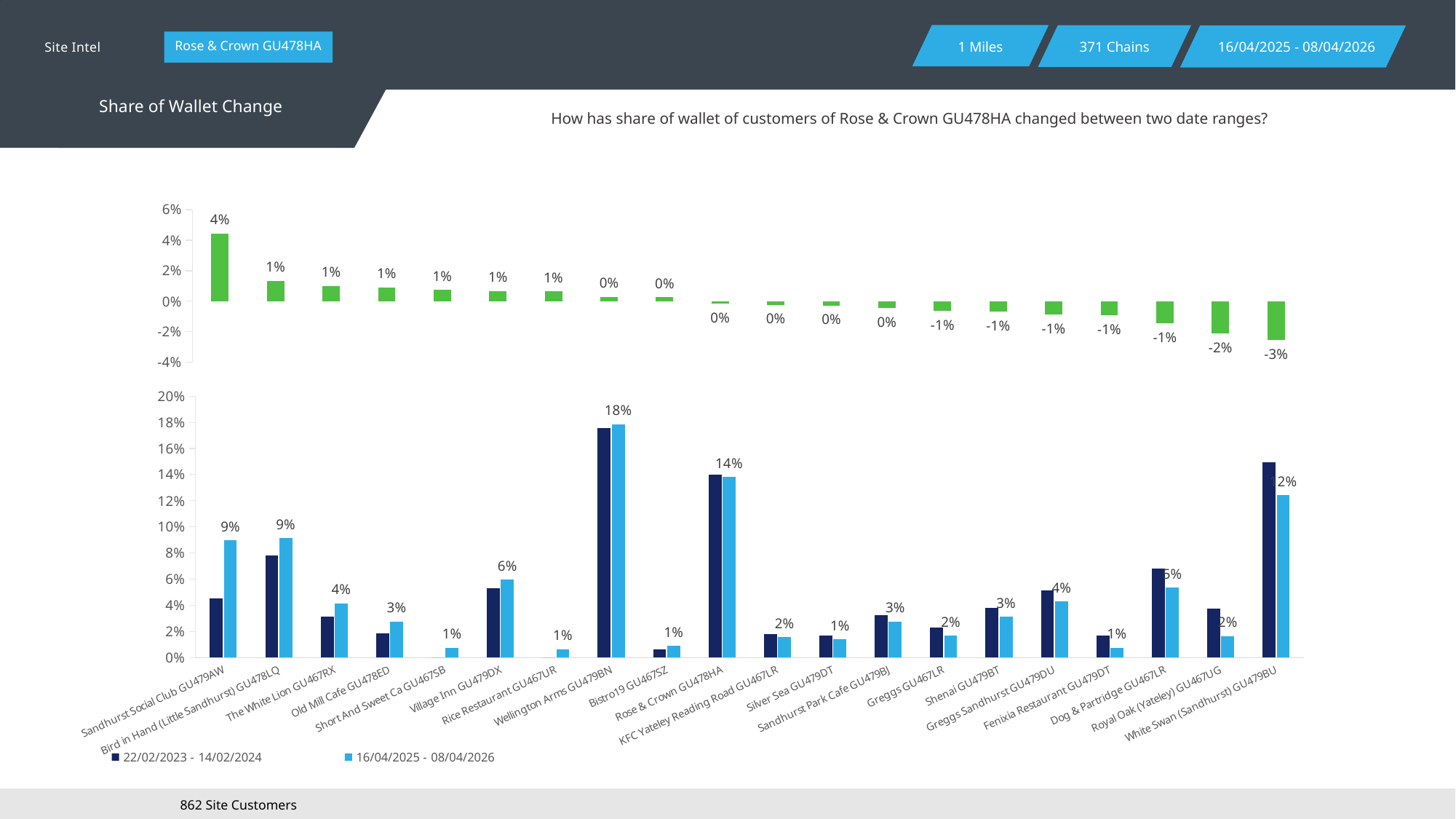
How many sites are shown on the x axis of the bottom chart? 20 In the bottom chart, what is the 16/04/2025 - 08/04/2026 share of wallet for Rose & Crown GU478HA? 14% In the bottom chart, is the 22/02/2023 - 14/02/2024 value for Wellington Arms GU479BN greater or less than 16%? greater In the top chart, what is the difference in percentage points between the change for Sandhurst Social Club GU479AW and White Swan (Sandhurst) GU479BU? 7 percentage points In the top chart, which site has the lowest share of wallet change? White Swan (Sandhurst) GU479BU In the top chart, which site has the highest share of wallet change? Sandhurst Social Club GU479AW In the top chart, what is the share of wallet change for Royal Oak (Yateley) GU467UG? -2% In the bottom chart, which has the larger 16/04/2025 - 08/04/2026 share of wallet: Wellington Arms GU479BN or Rose & Crown GU478HA? Wellington Arms GU479BN What kind of chart is the bottom chart? Bar chart How many series does the legend of the bottom chart list? 2 In the top chart, what is the share of wallet change for Sandhurst Social Club GU479AW? 4% In the bottom chart, what is the 16/04/2025 - 08/04/2026 share of wallet for Wellington Arms GU479BN? 18%